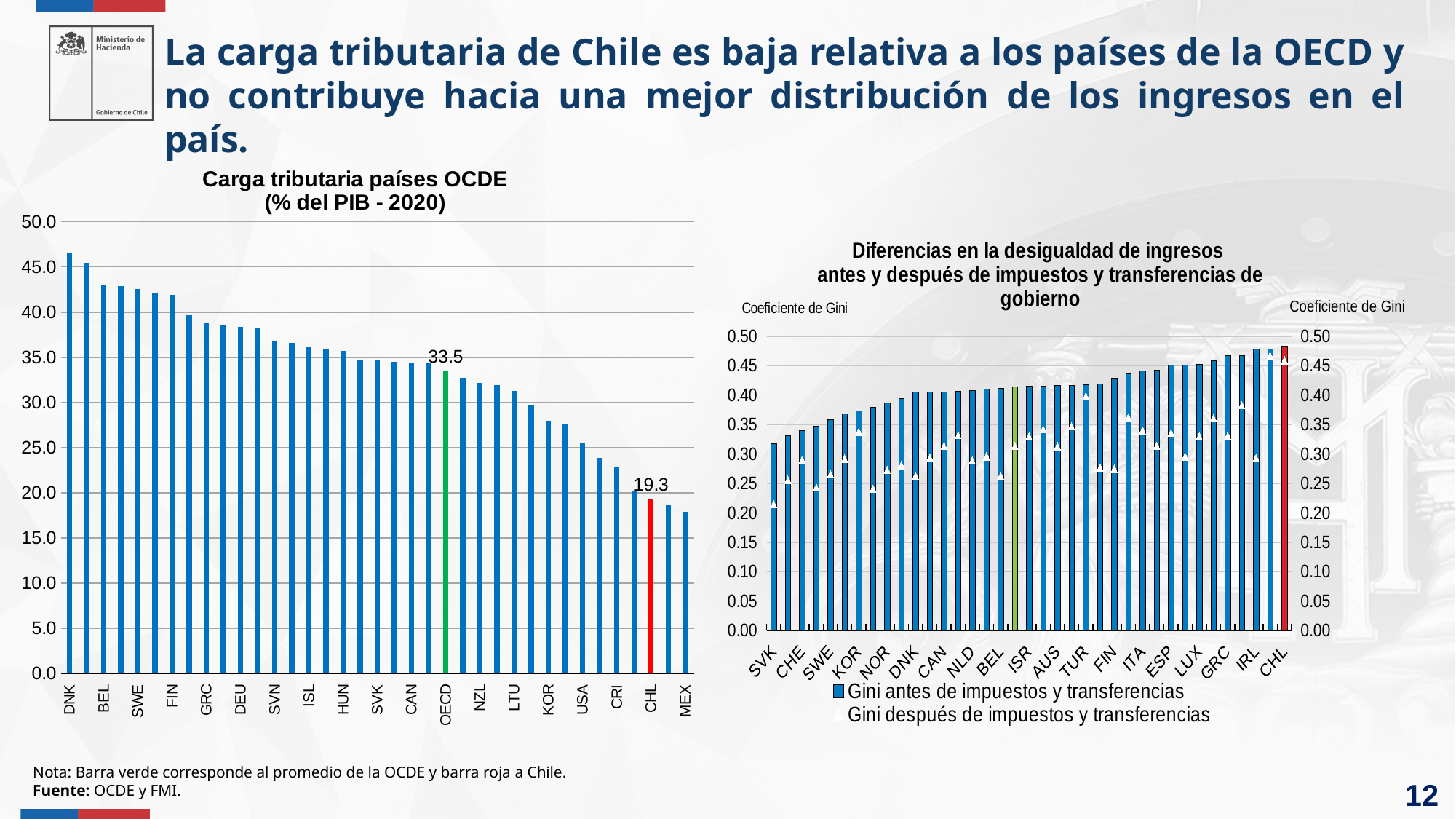
In the chart 'Carga tributaria países OCDE (% del PIB - 2020)', what is the value for OECD? 33.5 In the chart 'Carga tributaria países OCDE (% del PIB - 2020)', which country has the highest value? DNK In the chart 'Carga tributaria países OCDE (% del PIB - 2020)', what is the value for CHL? 19.3 In the chart 'Diferencias en la desigualdad de ingresos antes y después de impuestos y transferencias de gobierno', which country has the highest 'Gini antes de impuestos y transferencias' bar? CHL In the chart 'Carga tributaria países OCDE (% del PIB - 2020)', what is the difference between the OECD value and the CHL value? 14.2 In the chart 'Carga tributaria países OCDE (% del PIB - 2020)', which country has the lowest value? MEX In the chart 'Diferencias en la desigualdad de ingresos antes y después de impuestos y transferencias de gobierno', is the 'Gini antes de impuestos y transferencias' value for SVK greater or less than 0.35? less What kind of chart is 'Carga tributaria países OCDE (% del PIB - 2020)'? Bar chart In the chart 'Carga tributaria países OCDE (% del PIB - 2020)', is the value for USA greater or less than 30.0? less In the chart 'Carga tributaria países OCDE (% del PIB - 2020)', do the values rise or fall from left to right? Fall In the chart 'Carga tributaria países OCDE (% del PIB - 2020)', which is larger, the value for KOR or the value for USA? KOR How many series does the legend of the chart 'Diferencias en la desigualdad de ingresos antes y después de impuestos y transferencias de gobierno' list? 2